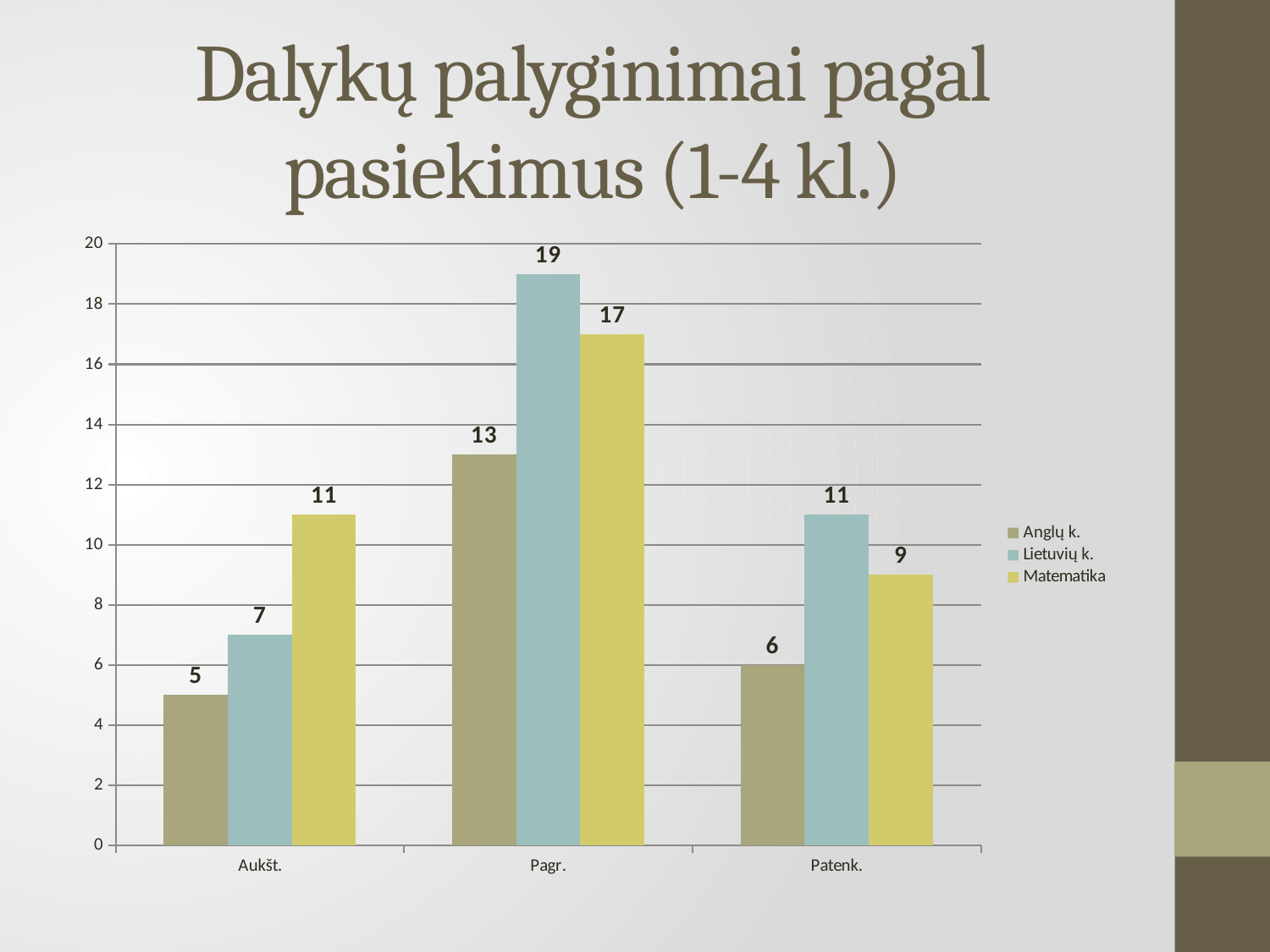
Which category has the highest value for Anglų k.? Pagr. What is the difference between the Lietuvių k. and Matematika values in the Pagr. category? 2 What is the difference between the Anglų k. values for Patenk. and Aukšt.? 1 How many categories are shown on the x axis? 3 Which is larger in the Aukšt. category: Lietuvių k. or Matematika? Matematika What is the value for Anglų k. in the Aukšt. category? 5 How many series does the legend list? 3 What kind of chart is shown on the slide? Bar chart What is the value for Matematika in the Patenk. category? 9 What is the title of the slide? Dalykų palyginimai pagal pasiekimus (1-4 kl.) Which category has the lowest value for Matematika? Patenk. What is the value for Lietuvių k. in the Pagr. category? 19